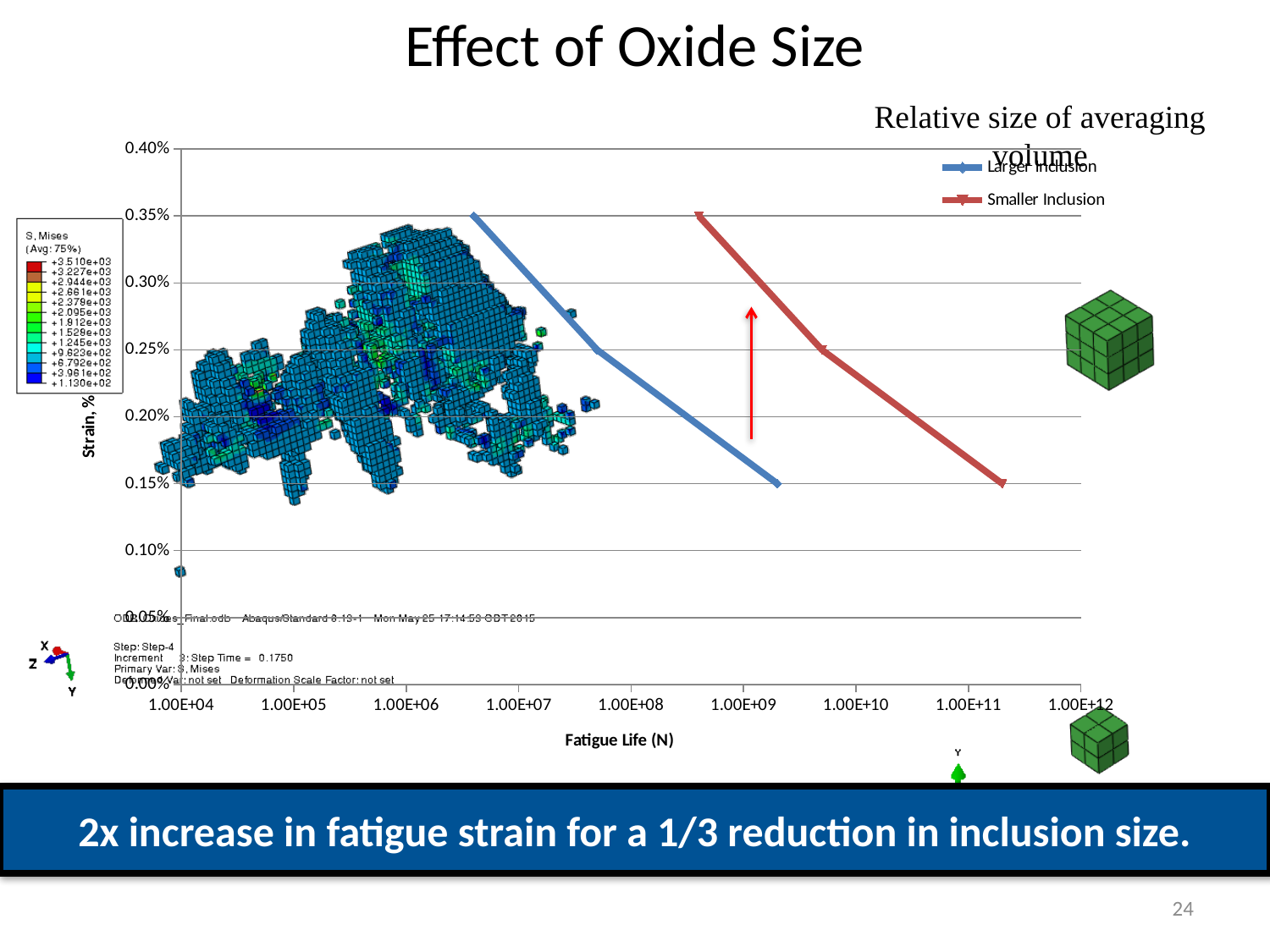
Does the strain for the Smaller Inclusion series rise or fall as fatigue life increases? fall Is the fatigue life at the lowest-strain point of the Smaller Inclusion series greater or less than 1.00E+10? greater What is the highest strain value plotted for the Smaller Inclusion series? 0.35% How many series does the chart legend list? 2 Is the fatigue life of the Smaller Inclusion series at 0.25% strain greater or less than 1.00E+09? greater Is the fatigue life of the Larger Inclusion series at 0.25% strain greater or less than 1.00E+08? less At a strain of 0.25%, which series has the longer fatigue life, Larger Inclusion or Smaller Inclusion? Smaller Inclusion Does the strain for the Larger Inclusion series rise or fall as fatigue life increases? fall What is the lowest strain value plotted for the Larger Inclusion series? 0.15% What are the two series named in the chart legend? Larger Inclusion and Smaller Inclusion What is the title of the chart's x axis? Fatigue Life (N) What kind of chart is shown on the slide? line chart